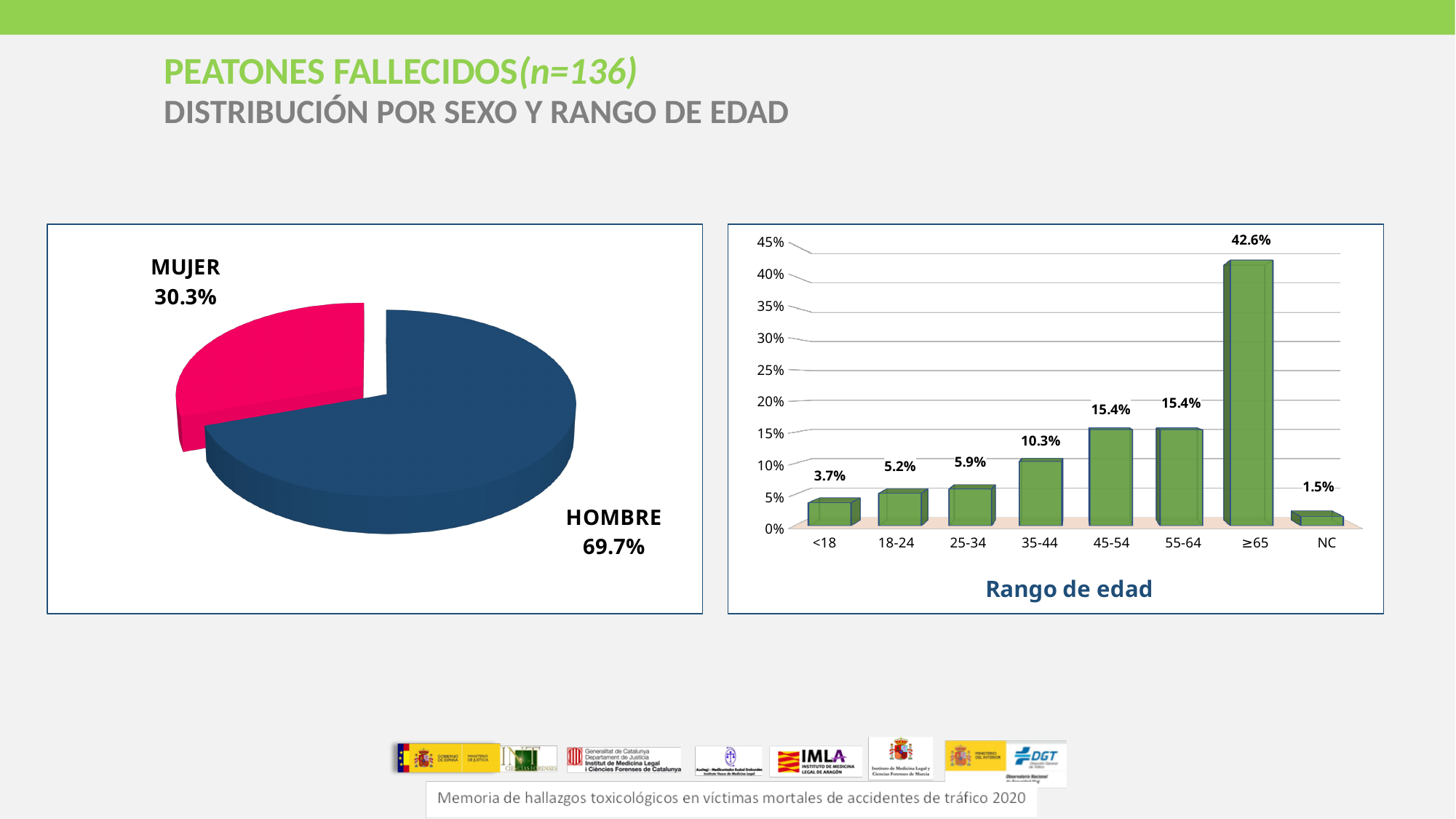
In the bar chart on the right, which age range has the highest value? ≥65 In the bar chart on the right, what is the value for the ≥65 age range? 42.6% In the pie chart on the left, what percentage is shown for MUJER? 30.3% In the bar chart on the right, which category has the lowest value? NC In the pie chart on the left, what is the difference between the HOMBRE and MUJER percentages? 39.4% In the bar chart on the right, what is the value for the 35-44 age range? 10.3% What kind of chart is the chart on the right (Rango de edad)? Bar chart In the pie chart on the left, what percentage is shown for HOMBRE? 69.7% In the bar chart on the right, what is the difference between the values for ≥65 and 55-64? 27.2% In the bar chart on the right, how many categories are shown on the x axis? 8 What kind of chart is the chart on the left? Pie chart In the pie chart on the left, which category has the larger share, HOMBRE or MUJER? HOMBRE